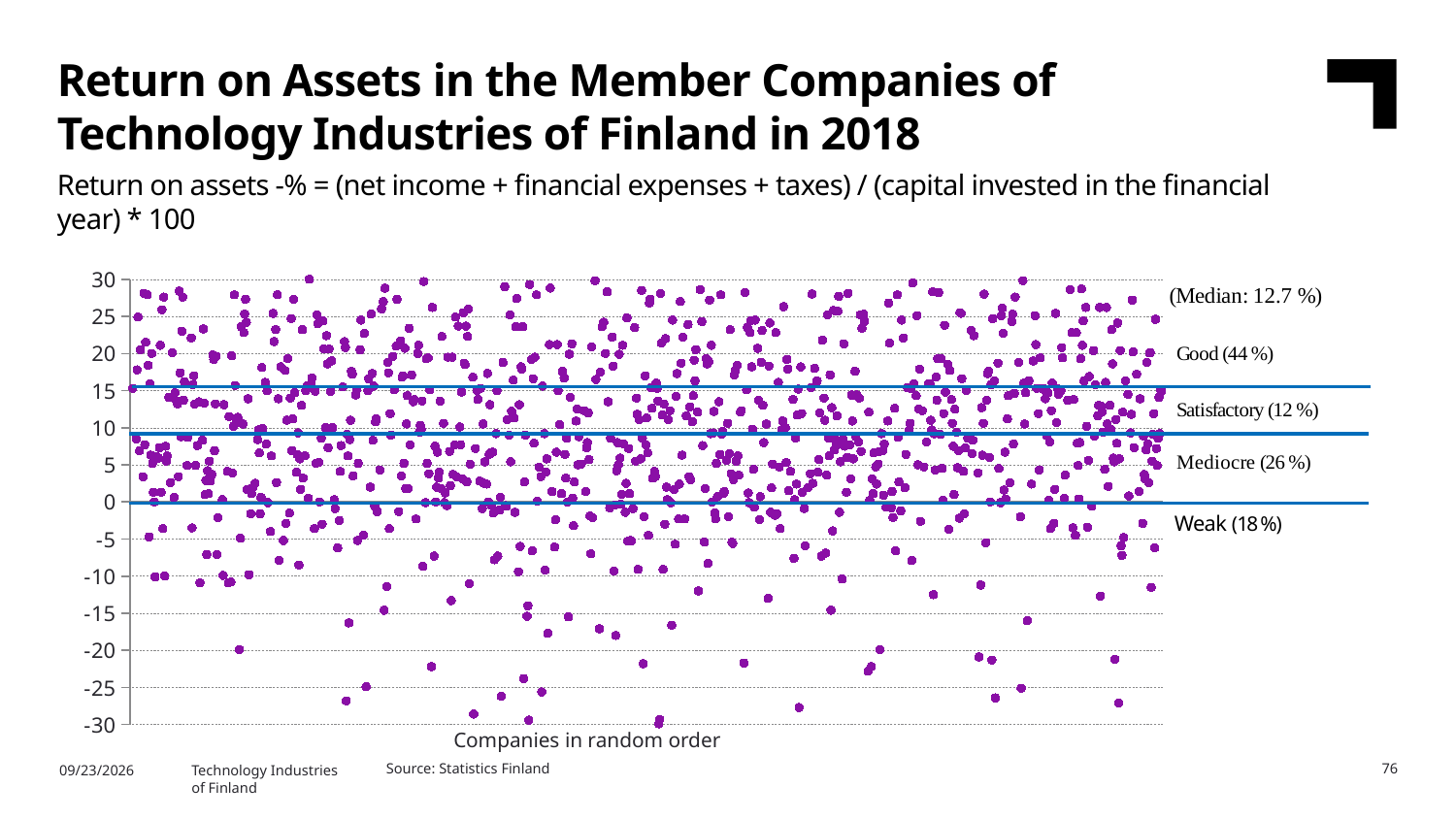
What share of companies falls into the 'Satisfactory' category? 12 % What share of companies falls into the 'Good' category? 44 % Which category has a larger share of companies, 'Mediocre' or 'Weak'? Mediocre Which return-on-assets category has the largest share of companies? Good Which return-on-assets category has the smallest share of companies? Satisfactory How many return-on-assets categories are labelled on the chart? 4 What is the median return on assets shown on the chart? 12.7 % What is the difference in percentage points between the share of 'Good' companies and the share of 'Weak' companies? 26 What is the label of the x axis of the chart? Companies in random order What kind of chart is shown on the slide? Scatter chart What share of companies falls into the 'Mediocre' category? 26 % What share of companies falls into the 'Weak' category? 18 %